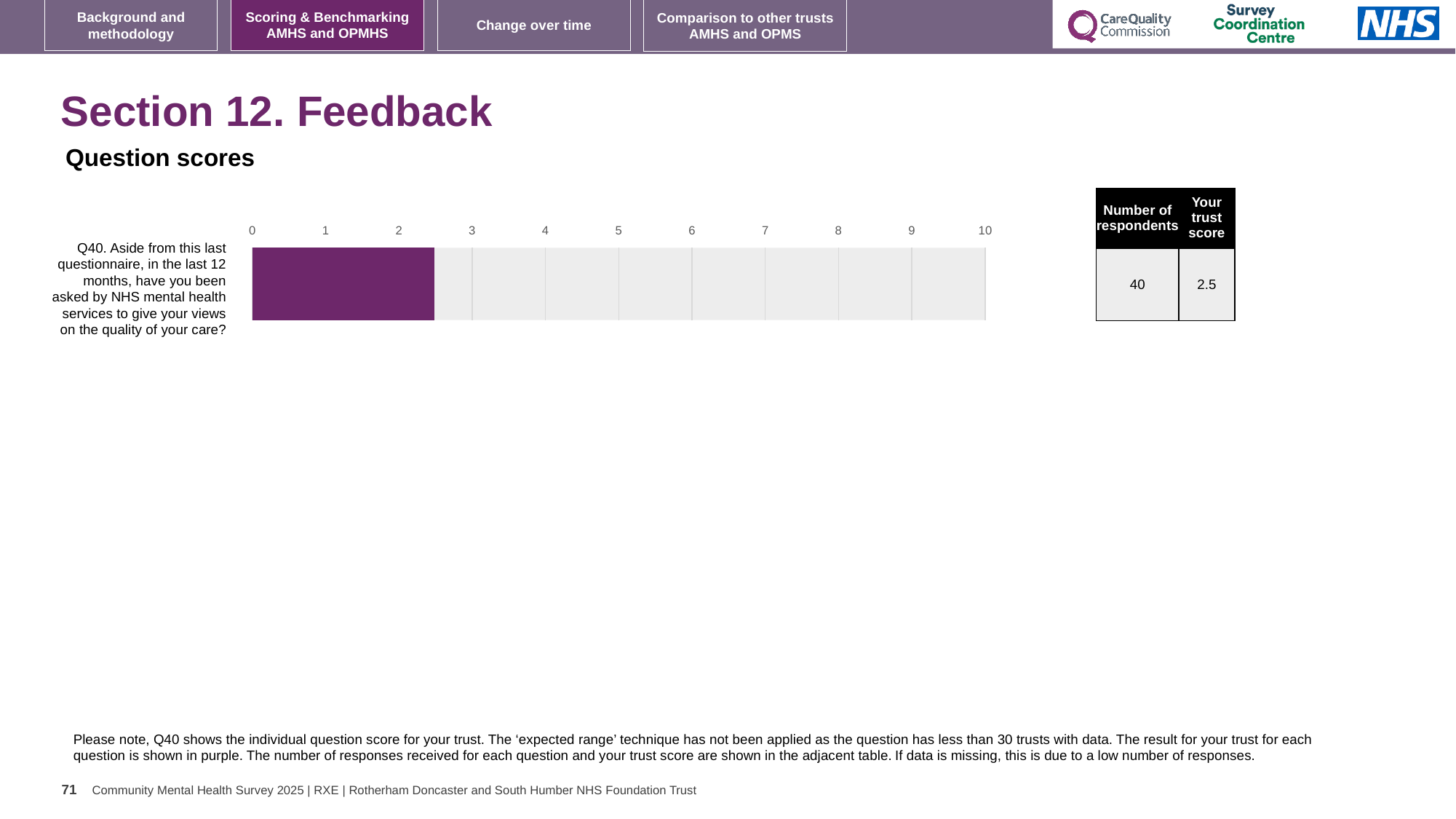
What is the trust score for Q40 shown on the chart? 2.5 How many respondents are listed for Q40 in the table next to the chart? 40 Is the value for Q40 greater or less than 5? less What kind of chart is shown on the slide? Bar chart What colour is the bar for Q40? Purple Is the value for Q40 greater or less than 2? greater How many questions (bars) are plotted on the chart? 1 Is the value for Q40 greater or less than 3? less What is the maximum value shown on the chart's axis? 10